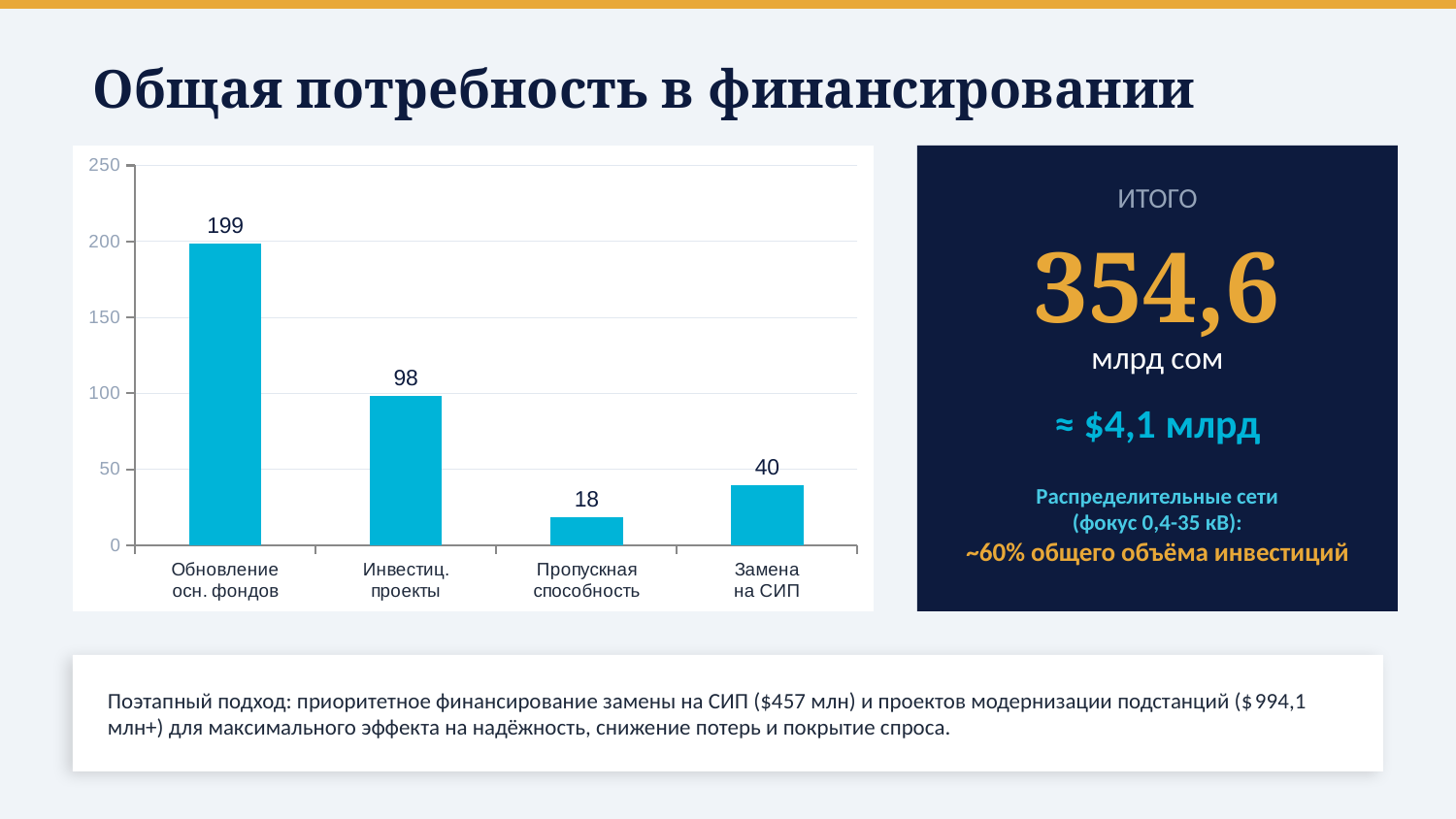
What kind of chart is shown on the slide? bar chart How many categories are shown in the chart? 4 What is the value for Инвестиц. проекты? 98 What is the difference between the values for Замена на СИП and Пропускная способность? 22 What is the value for Замена на СИП? 40 What is the difference between the values for Обновление осн. фондов and Инвестиц. проекты? 101 Which is larger, the value for Замена на СИП or the value for Пропускная способность? Замена на СИП What is the value for Пропускная способность? 18 Is the value for Инвестиц. проекты greater or less than 100? less Which category has the highest value? Обновление осн. фондов Which category has the lowest value? Пропускная способность What is the value for Обновление осн. фондов? 199